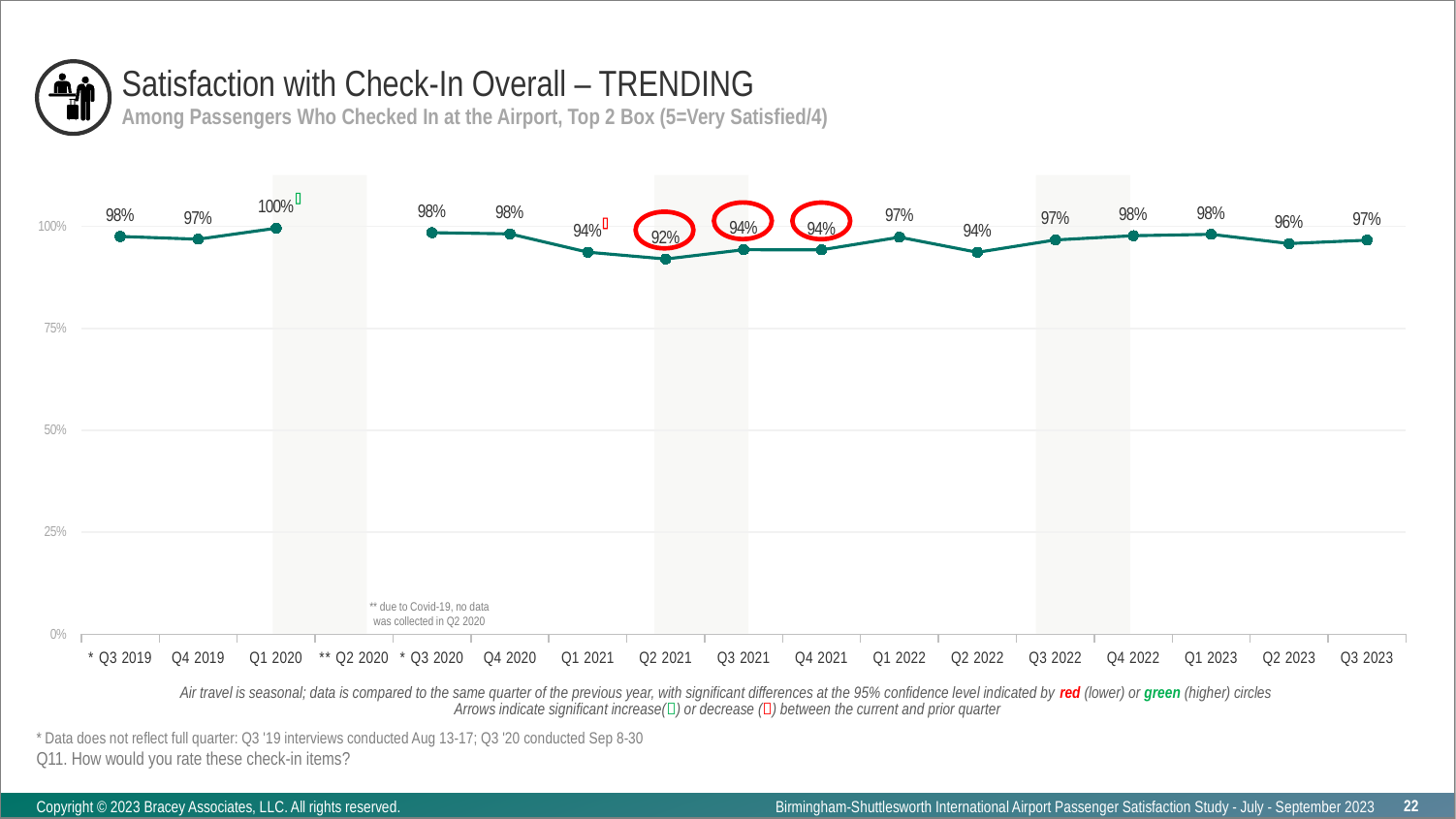
What kind of chart is shown on the slide? line chart Which is larger, the value for Q1 2022 or the value for Q2 2022? Q1 2022 What is the difference between the values for Q1 2020 and Q2 2021? 8% What is the value for Q2 2023? 96% For which quarter was no data collected? Q2 2020 What is the value for Q2 2021? 92% What is the value for Q1 2020? 100% What is the difference between the values for Q4 2022 and Q2 2023? 2% What is the value for Q3 2023? 97% Which quarter has the lowest value? Q2 2021 What is the title of the chart? Satisfaction with Check-In Overall – TRENDING Which quarter has the highest value? Q1 2020